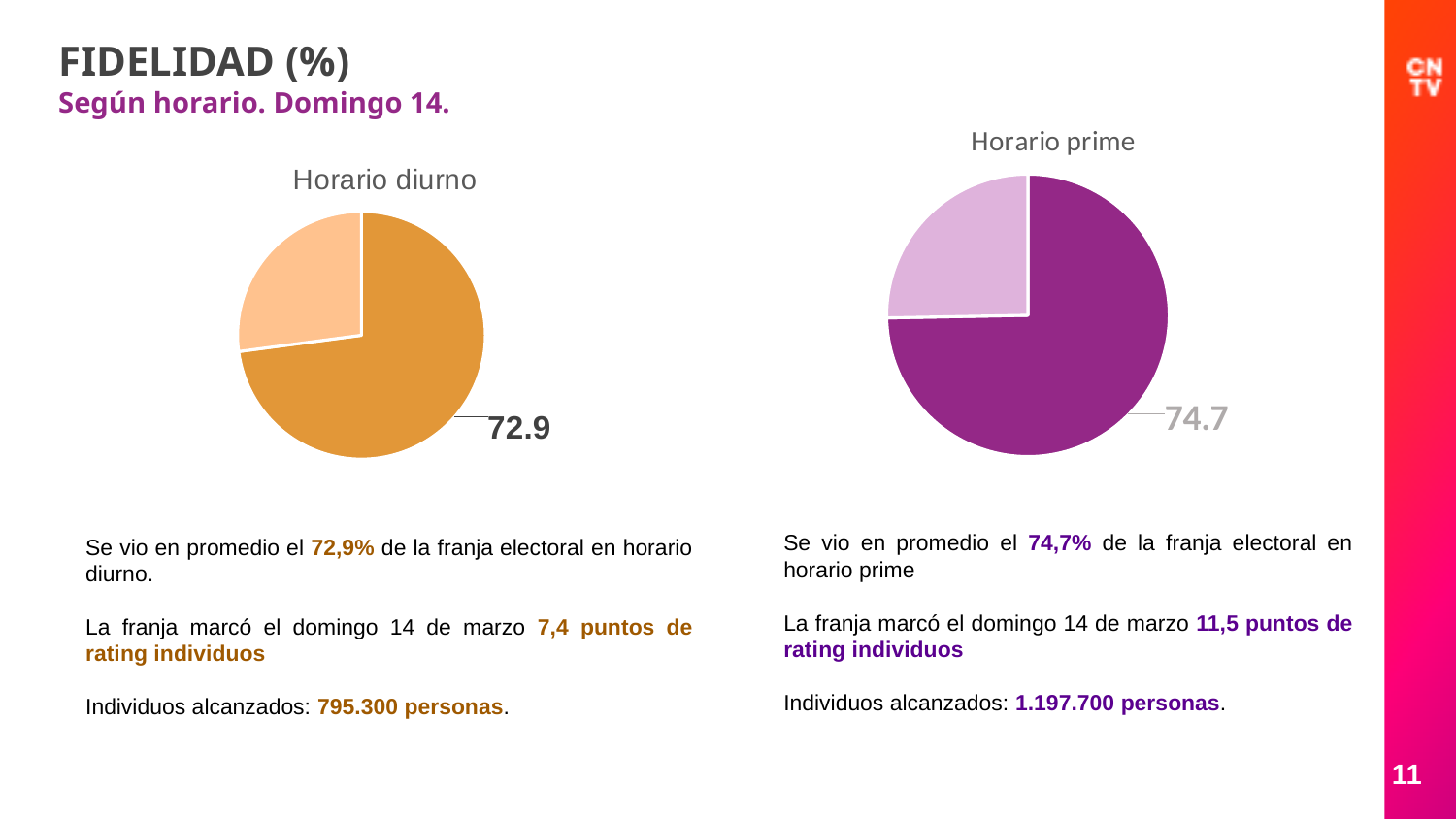
In the Horario prime pie chart, is the slice labeled 74.7 the larger or the smaller slice? Larger How many slices does the Horario diurno pie chart have? 2 What kind of chart is the Horario diurno chart? Pie chart In the Horario diurno pie chart, is the slice labeled 72.9 the larger or the smaller slice? Larger In the Horario diurno pie chart, what value is printed on the labeled slice? 72.9 What is the difference between the labeled value in the Horario prime chart and the labeled value in the Horario diurno chart? 1.8 Which chart has the larger labeled value, Horario diurno or Horario prime? Horario prime What colour is the larger slice in the Horario prime pie chart? Purple How many slices does the Horario prime pie chart have? 2 In the Horario prime pie chart, what value is printed on the labeled slice? 74.7 How many pie charts are shown on the slide? 2 What is the title of the pie chart on the left of the slide? Horario diurno